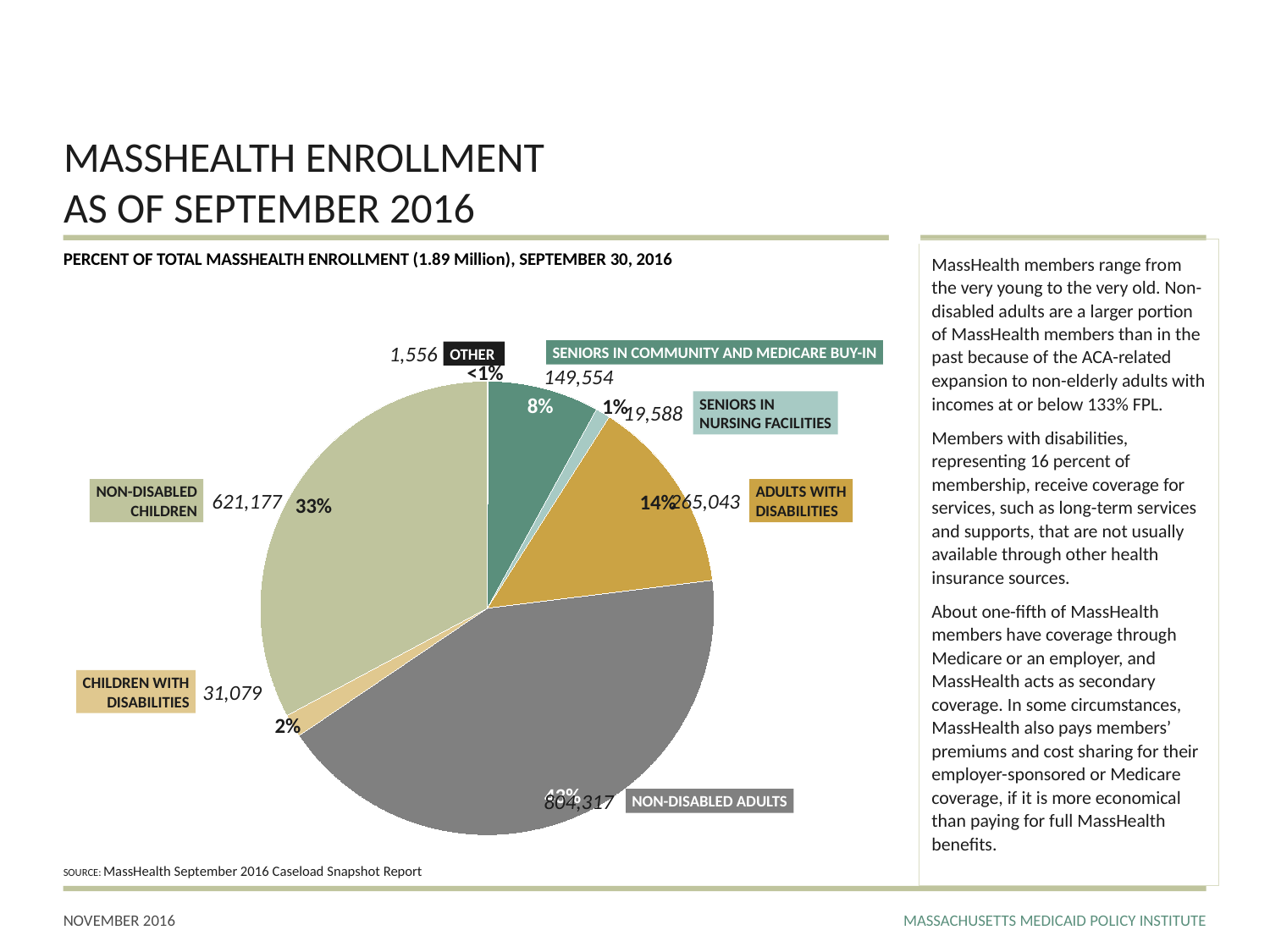
How many categories are shown in the pie chart? 7 Which category has the smallest share of MassHealth enrollment? Other How many more members are Non-Disabled Adults than Non-Disabled Children? 183,140 What kind of chart is shown on the slide? pie chart What share of the pie do Non-Disabled Children represent? 33% Which group has more members: Non-Disabled Children or Adults with Disabilities? Non-Disabled Children What is the enrollment number shown for Adults with Disabilities? 265,043 What is the enrollment number shown for Children with Disabilities? 31,079 Which category has the largest share of MassHealth enrollment? Non-Disabled Adults What percentage of total enrollment is Seniors in Community and Medicare Buy-In? 8% How many MassHealth members are Non-Disabled Children according to the pie chart? 621,177 What is the enrollment number shown for Non-Disabled Adults? 804,317